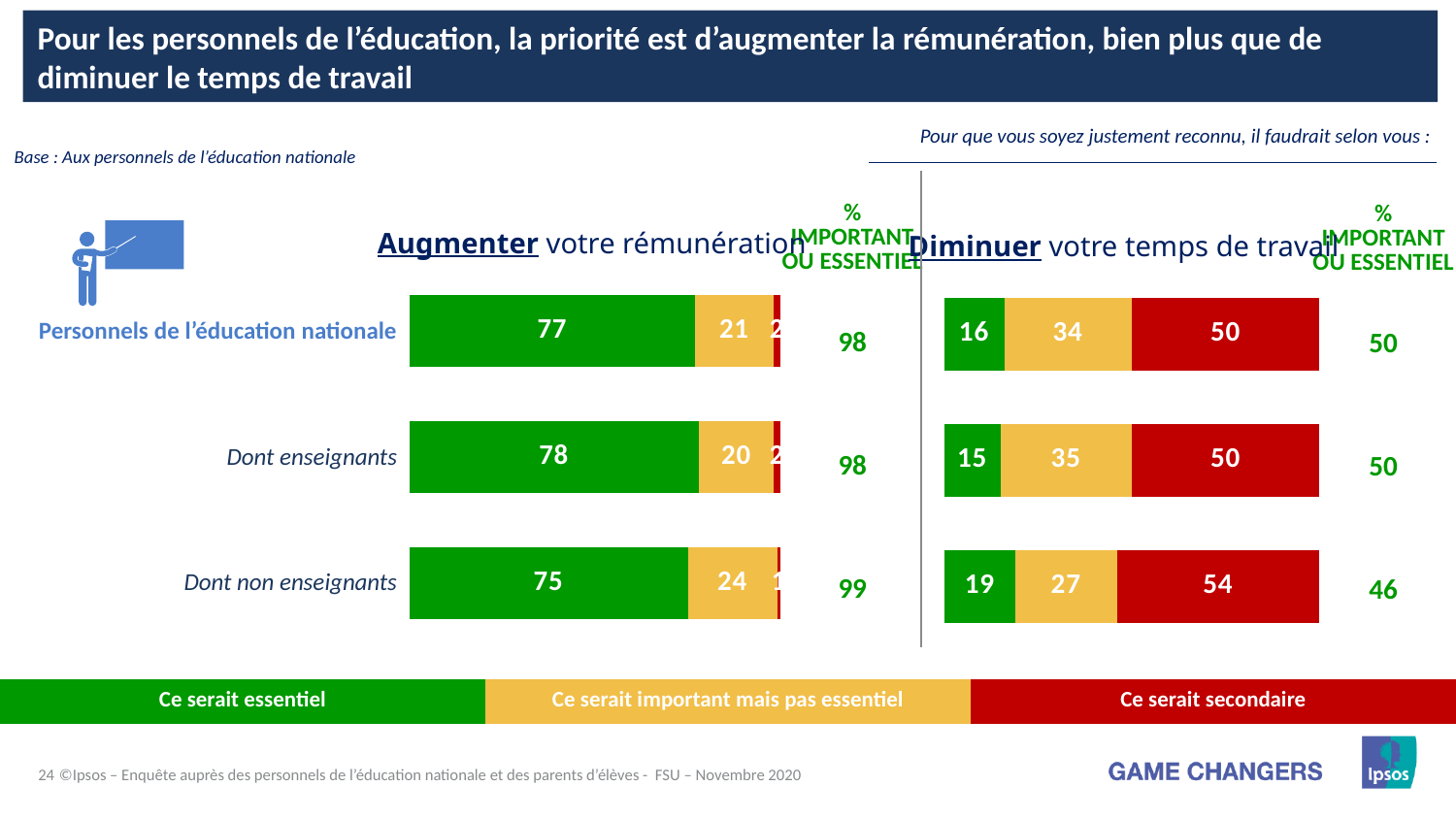
In the 'Diminuer votre temps de travail' chart, what is the value of 'Ce serait important mais pas essentiel' for 'Personnels de l'éducation nationale'? 34 In the 'Augmenter votre rémunération' chart, what is the value of 'Ce serait essentiel' for 'Dont enseignants'? 78 What type of chart is used for 'Diminuer votre temps de travail'? Stacked bar chart How many series does the legend at the bottom of the slide list? 3 In the 'Diminuer votre temps de travail' chart, which is larger for 'Dont non enseignants': 'Ce serait essentiel' or 'Ce serait important mais pas essentiel'? Ce serait important mais pas essentiel In the 'Augmenter votre rémunération' chart, what is the difference between the 'Ce serait essentiel' values for 'Dont enseignants' and 'Dont non enseignants'? 3 In the 'Diminuer votre temps de travail' chart, what is the '% IMPORTANT OU ESSENTIEL' value for 'Dont non enseignants'? 46 Which colour represents 'Ce serait secondaire' in the charts? Red In the 'Augmenter votre rémunération' chart, which category has the highest 'Ce serait essentiel' value? Dont enseignants In the 'Diminuer votre temps de travail' chart, what is the value of 'Ce serait secondaire' for 'Dont non enseignants'? 54 How many categories are shown in the 'Augmenter votre rémunération' chart? 3 In the 'Diminuer votre temps de travail' chart, which category has the lowest 'Ce serait important mais pas essentiel' value? Dont non enseignants